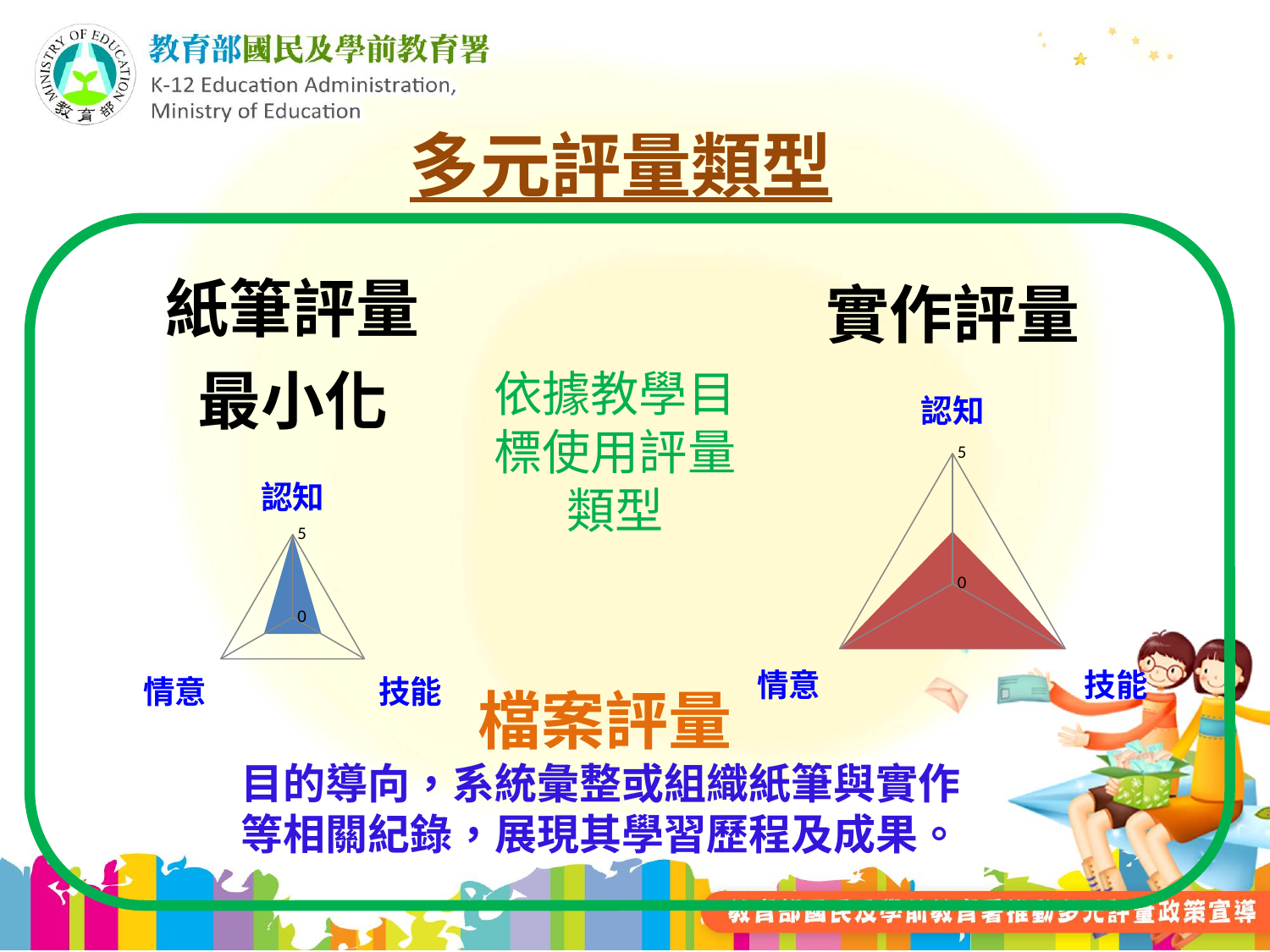
In the right radar chart under 實作評量, what is the value for 情意? 5 In the right radar chart under 實作評量, which category has the lowest value? 認知 In the right radar chart under 實作評量, is the value for 認知 greater or less than 5? less How many categories (axes) does the right radar chart under 實作評量 have? 3 In the left radar chart under 紙筆評量, which is larger, the value for 認知 or the value for 技能? 認知 How many categories (axes) does the left radar chart under 紙筆評量 have? 3 In the left radar chart under 紙筆評量, is the value for 情意 greater or less than 5? less In the left radar chart under 紙筆評量, which category has the highest value? 認知 What is the maximum value shown on the axis scale of the right radar chart under 實作評量? 5 What kind of chart is shown under 紙筆評量 on the left of the slide? radar chart In the right radar chart under 實作評量, what is the value for 技能? 5 In the left radar chart under 紙筆評量, what is the value for 認知? 5